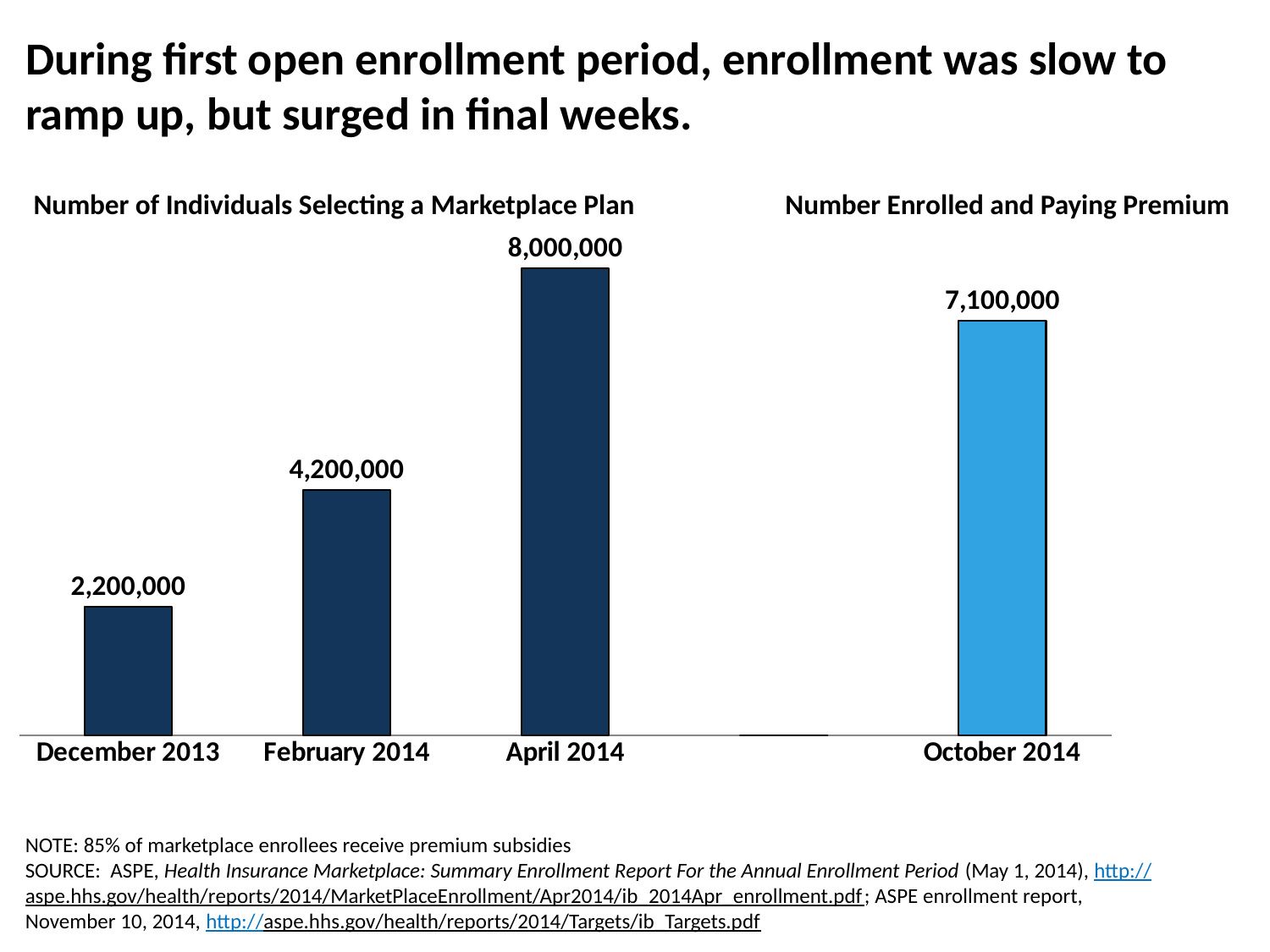
What is the difference between the April 2014 value and the February 2014 value? 3,800,000 Which month has the highest bar? April 2014 What is the value shown for October 2014? 7,100,000 Which month has the lowest bar? December 2013 How many bars are plotted in the chart? 4 What is the value shown for February 2014? 4,200,000 Which is larger, the value for February 2014 or the value for October 2014? October 2014 What is the value shown for April 2014? 8,000,000 Which bar is shown in a lighter blue colour than the others? October 2014 What is the value shown for December 2013? 2,200,000 What is the difference between the April 2014 value and the October 2014 value? 900,000 What type of chart is shown on the slide? Bar chart